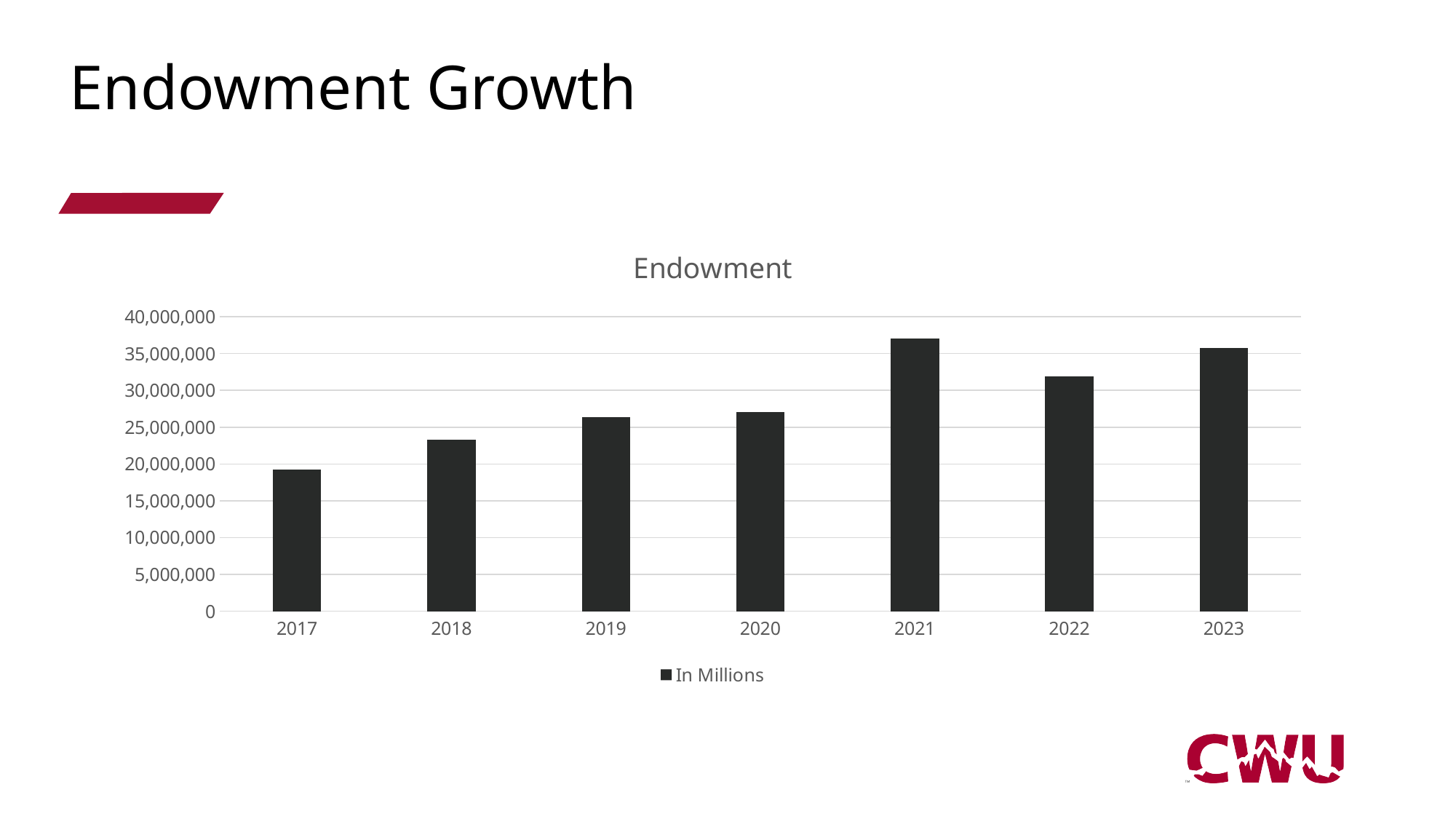
How many series does the legend of the Endowment chart list? 1 Which year has the highest endowment value? 2021 Is the endowment value for 2021 greater or less than 35,000,000? greater How many years are shown on the x axis of the Endowment chart? 7 Is the endowment value for 2017 greater or less than 20,000,000? less Is the endowment value for 2018 greater or less than 25,000,000? less What kind of chart is shown on the slide? bar chart Which year has the larger endowment value, 2022 or 2023? 2023 Do the endowment values rise or fall from 2017 to 2021? rise What is the legend entry shown below the Endowment chart? In Millions Which year has the lowest endowment value? 2017